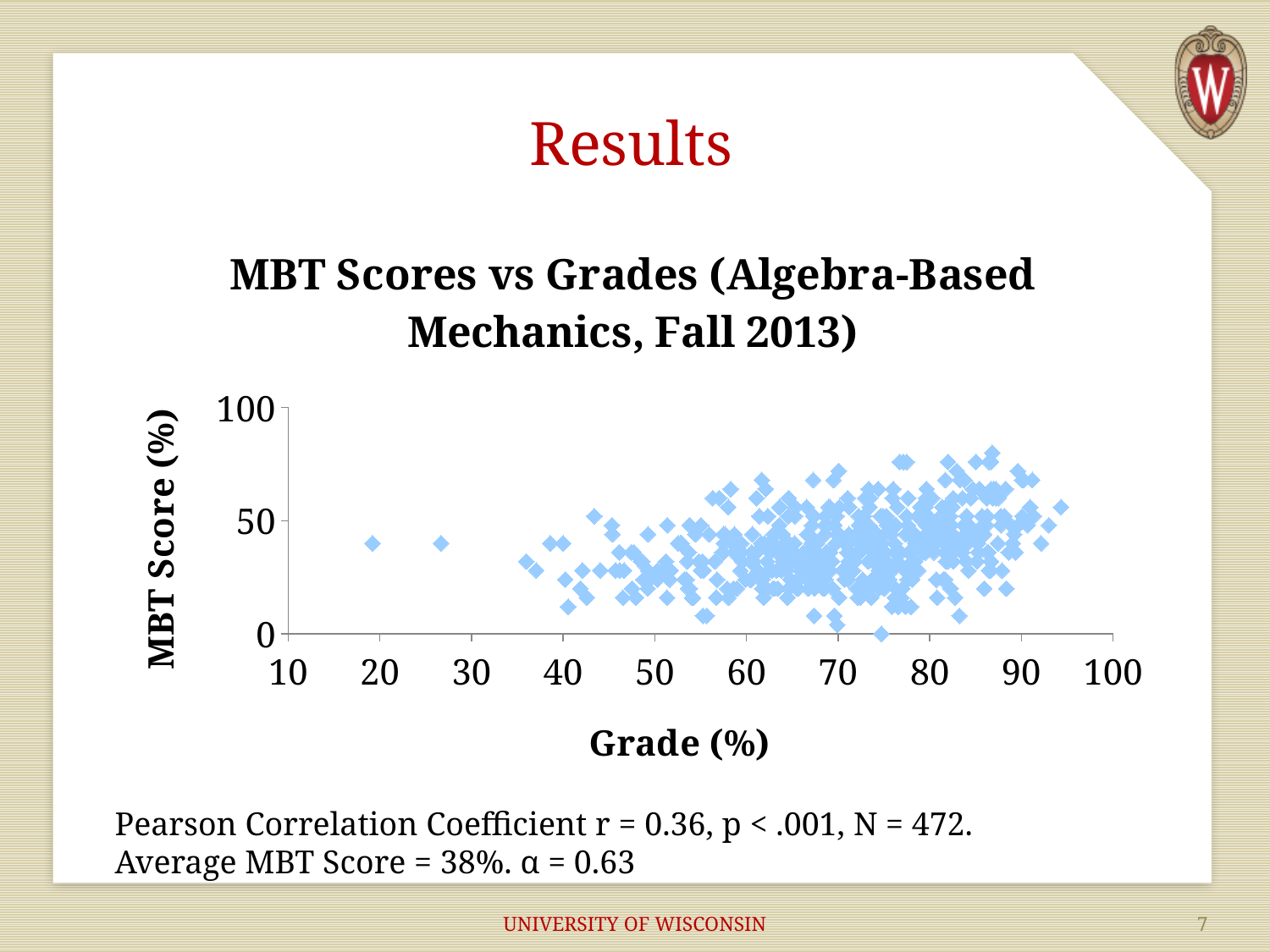
Do MBT scores generally rise or fall as Grade increases along the x axis? Rise Is the lowest Grade plotted on the chart greater or less than 30? less What is the title of the chart? MBT Scores vs Grades (Algebra-Based Mechanics, Fall 2013) What is the label of the horizontal axis of the chart? Grade (%) What is the minimum value shown on the Grade axis? 10 Is the lowest MBT Score plotted on the chart greater or less than 10? less Is the highest Grade plotted on the chart greater or less than 90? greater What is the Pearson correlation coefficient reported for the data in the chart? r = 0.36 What kind of chart is shown on the slide? Scatter plot What is the maximum value shown on the MBT Score axis? 100 How many data points (N) does the chart represent, according to the slide? 472